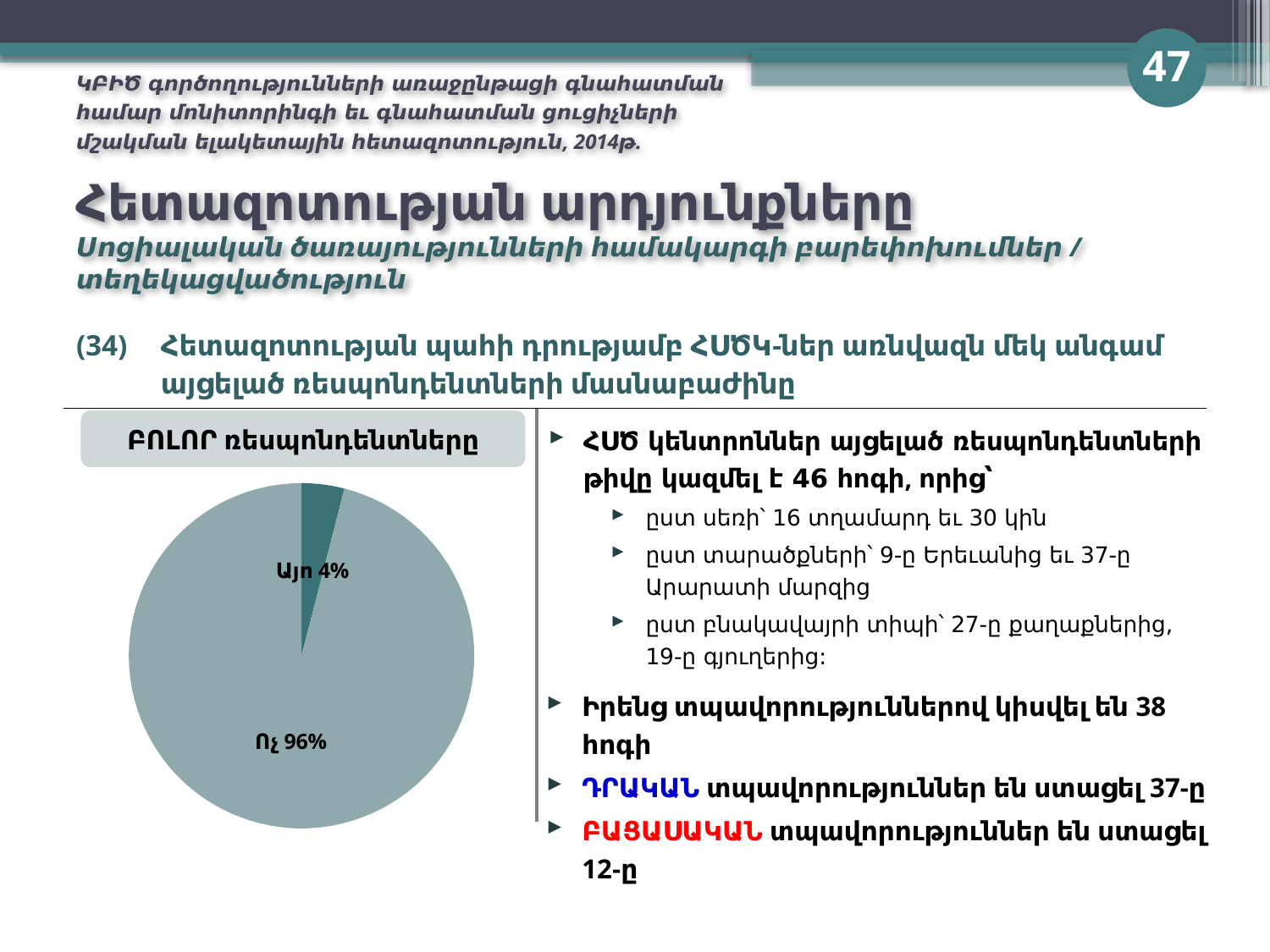
What is the title of the chart? ԲՈԼՈՐ ռեսպոնդենտները Which slice of the pie is the smallest? Այո What is the combined share of the "Այո" and "Ոչ" slices? 100% What share of the pie does the "Այո" slice represent? 4% Which slice of the pie is drawn in the darker teal colour? Այո Which is larger, the "Այո" slice or the "Ոչ" slice? Ոչ What kind of chart is shown on the slide? pie chart What is the difference in percentage points between the "Ոչ" slice and the "Այո" slice? 92 How many slices does the pie chart have? 2 Which slice of the pie is the largest? Ոչ What share of the pie does the "Ոչ" slice represent? 96%